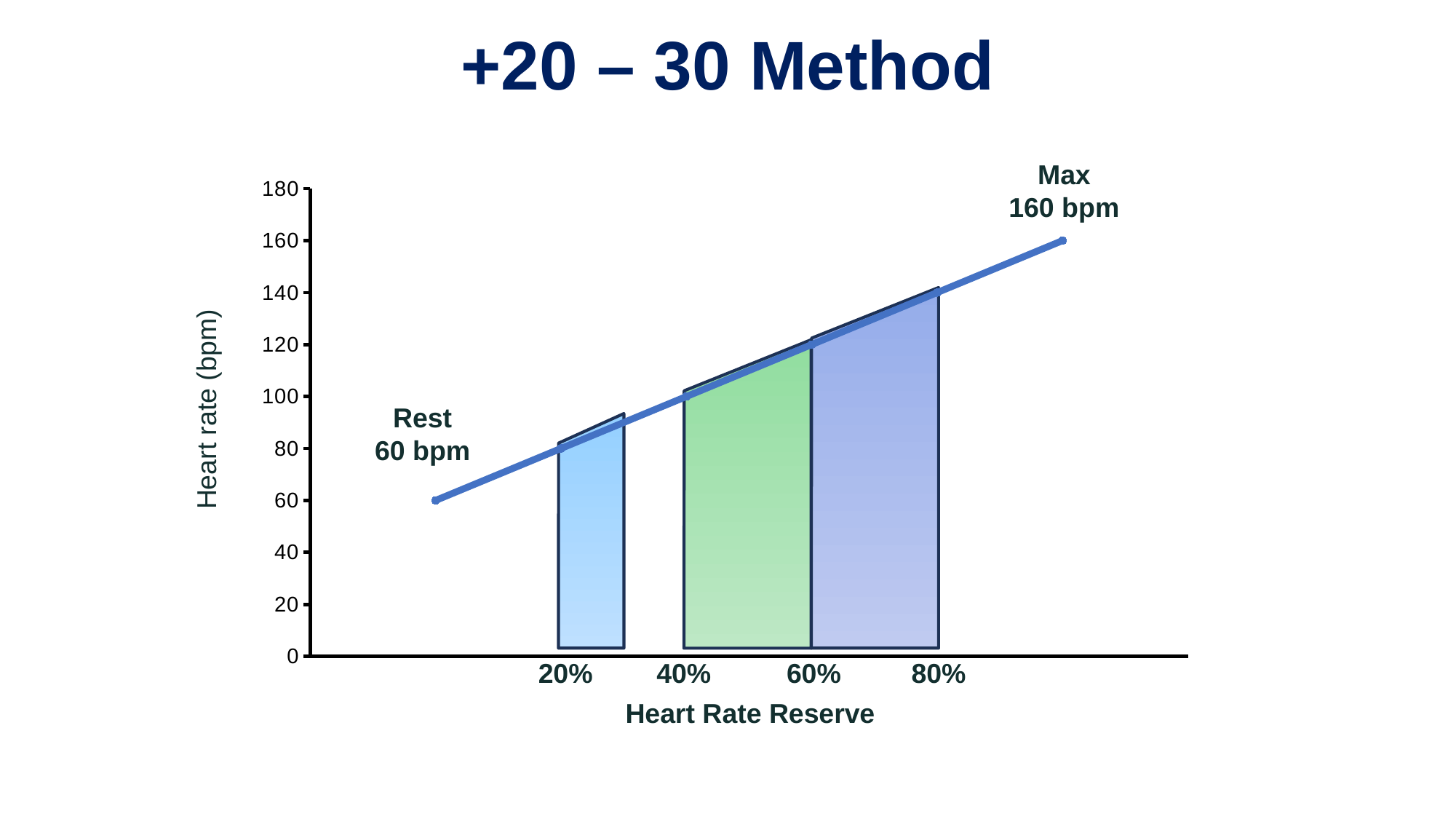
What is the difference between the Max and Rest heart rates shown on the chart? 100 bpm What is the title of the y axis? Heart rate (bpm) Is the heart rate at 60% Heart Rate Reserve greater or less than 100? greater How many percentage labels are shown on the x axis? 4 Is the heart rate at 20% Heart Rate Reserve greater or less than 100? less What is the title of the x axis? Heart Rate Reserve Which is larger, the Rest heart rate or the Max heart rate? Max Is the heart rate at 80% Heart Rate Reserve greater or less than 120? greater Does the heart rate line rise or fall as Heart Rate Reserve increases? rises What is the maximum heart rate labelled on the chart? 160 bpm What is the resting heart rate labelled on the chart? 60 bpm What kind of chart is shown on the slide? line chart